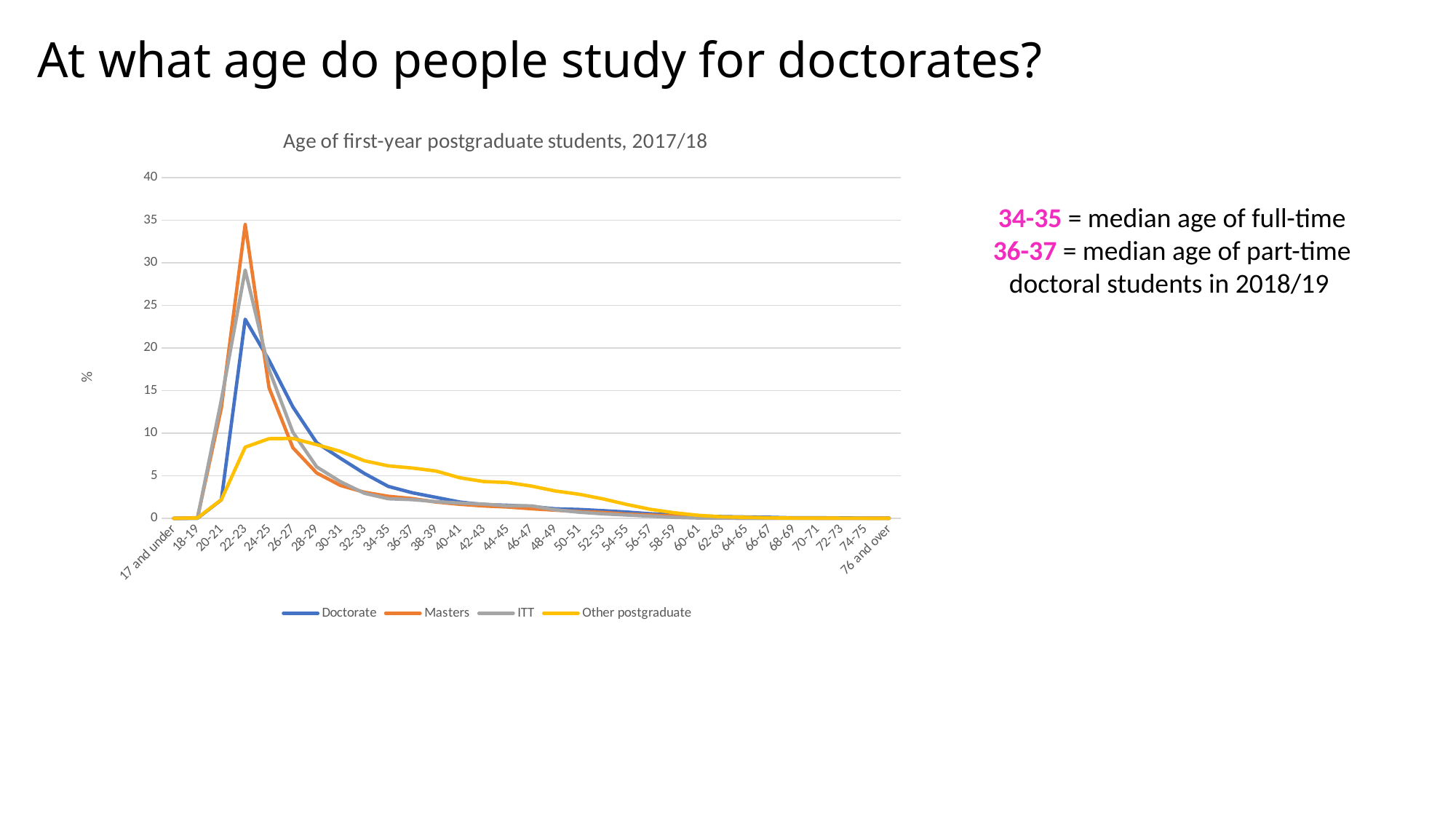
At the 36-37 age group, which is larger: the Other postgraduate value or the Doctorate value? Other postgraduate What is the title of the chart? Age of first-year postgraduate students, 2017/18 At the 22-23 age group, which is larger: the Masters value or the Doctorate value? Masters Does the Doctorate series rise or fall from the 22-23 age group to the 40-41 age group? fall Is the Masters value for the 22-23 age group greater or less than 30? greater How many series does the legend list? 4 How many age groups are shown along the x axis? 31 Which series reaches the highest peak value? Masters What kind of chart is shown on the slide? line chart In which age group does the Doctorate series reach its highest value? 22-23 Is the Other postgraduate value for the 22-23 age group greater or less than 10? less Is the Doctorate value for the 22-23 age group greater or less than 20? greater